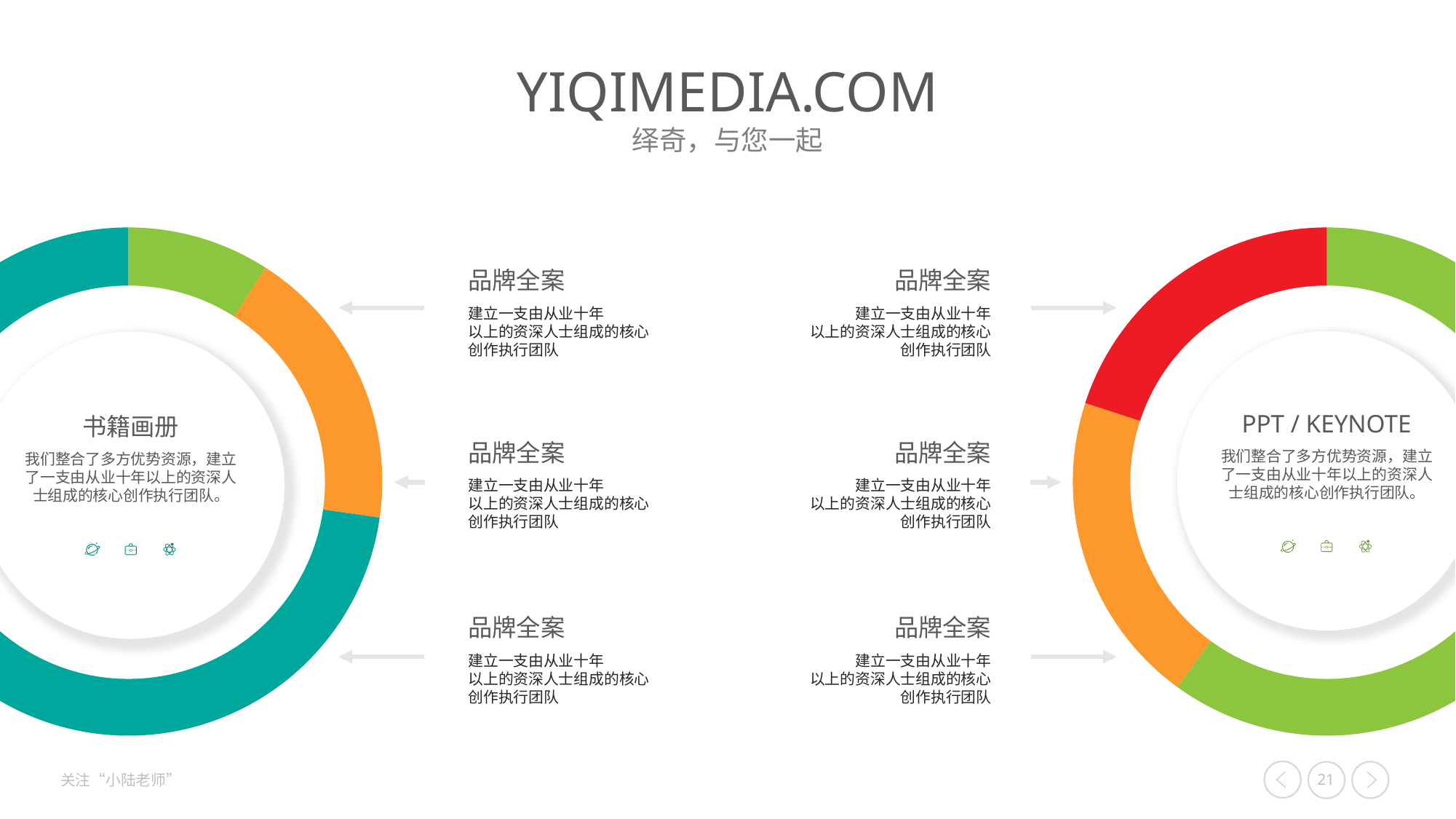
In the left chart (书籍画册), which colour slice takes up the largest part of the ring? teal How many different colours are used for the slices of the right chart (PPT / KEYNOTE)? 3 What text label sits in the centre of the right chart? PPT / KEYNOTE How many charts are on the slide? 2 In the right chart (PPT / KEYNOTE), which colour slice takes up the largest part of the ring? green In the right chart (PPT / KEYNOTE), is the green slice or the orange slice larger? green In the left chart (书籍画册), is the teal slice or the orange slice larger? teal What text label sits in the centre of the left chart? 书籍画册 What kind of chart is shown on the left side of the slide, next to the label 书籍画册? doughnut chart What kind of chart is shown on the right side of the slide, next to the label PPT / KEYNOTE? doughnut chart